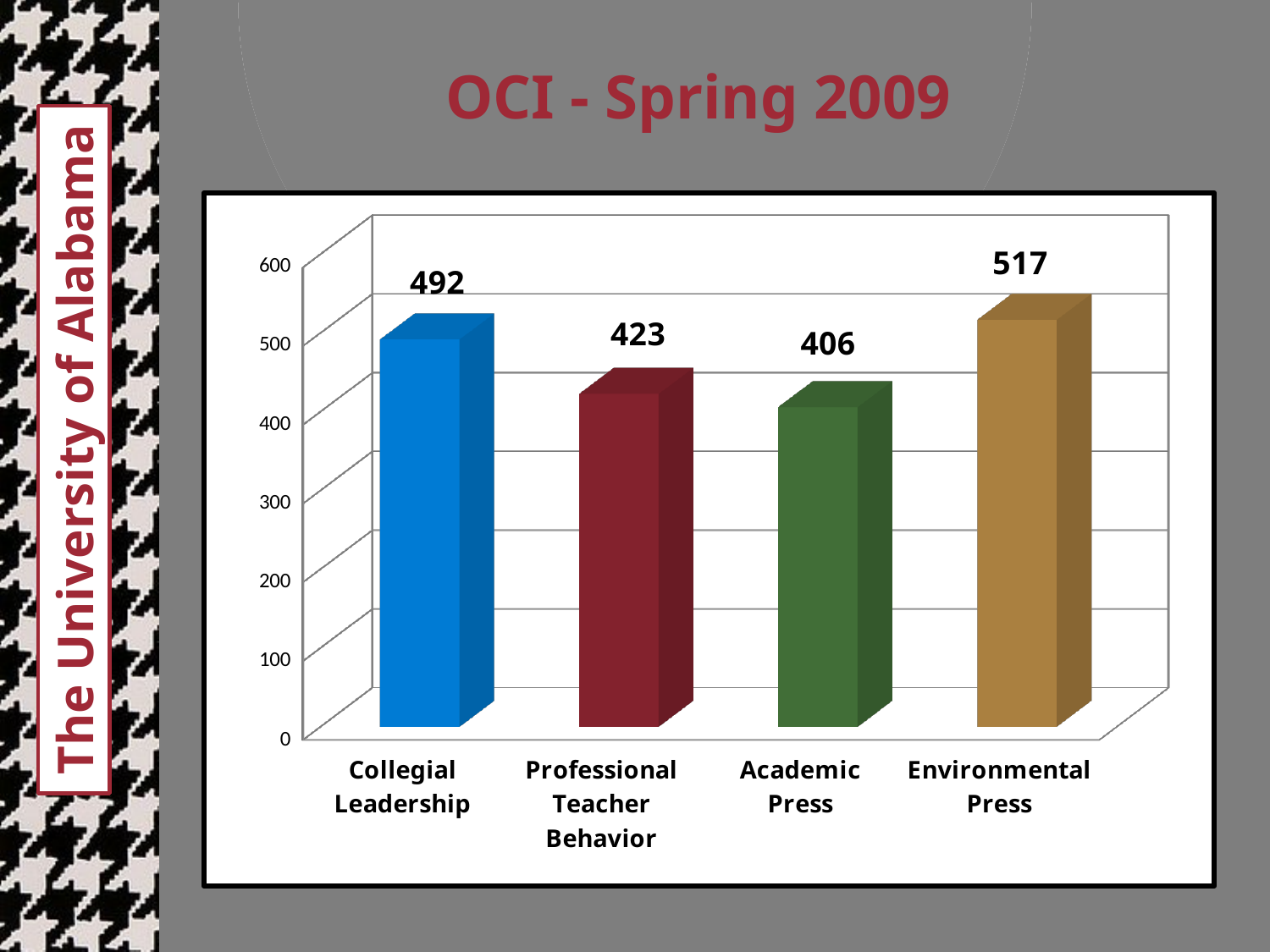
What is the difference between the values for Environmental Press and Academic Press? 111 What kind of chart is shown on the slide? Bar chart What is the difference between the values for Collegial Leadership and Professional Teacher Behavior? 69 What is the value for Environmental Press? 517 What is the value for Collegial Leadership? 492 Which category has the lowest value? Academic Press Which is larger, the value for Collegial Leadership or the value for Professional Teacher Behavior? Collegial Leadership What is the value for Academic Press? 406 Which category has the highest value? Environmental Press How many categories are shown in the chart? 4 What is the title of the chart? OCI - Spring 2009 What is the value for Professional Teacher Behavior? 423